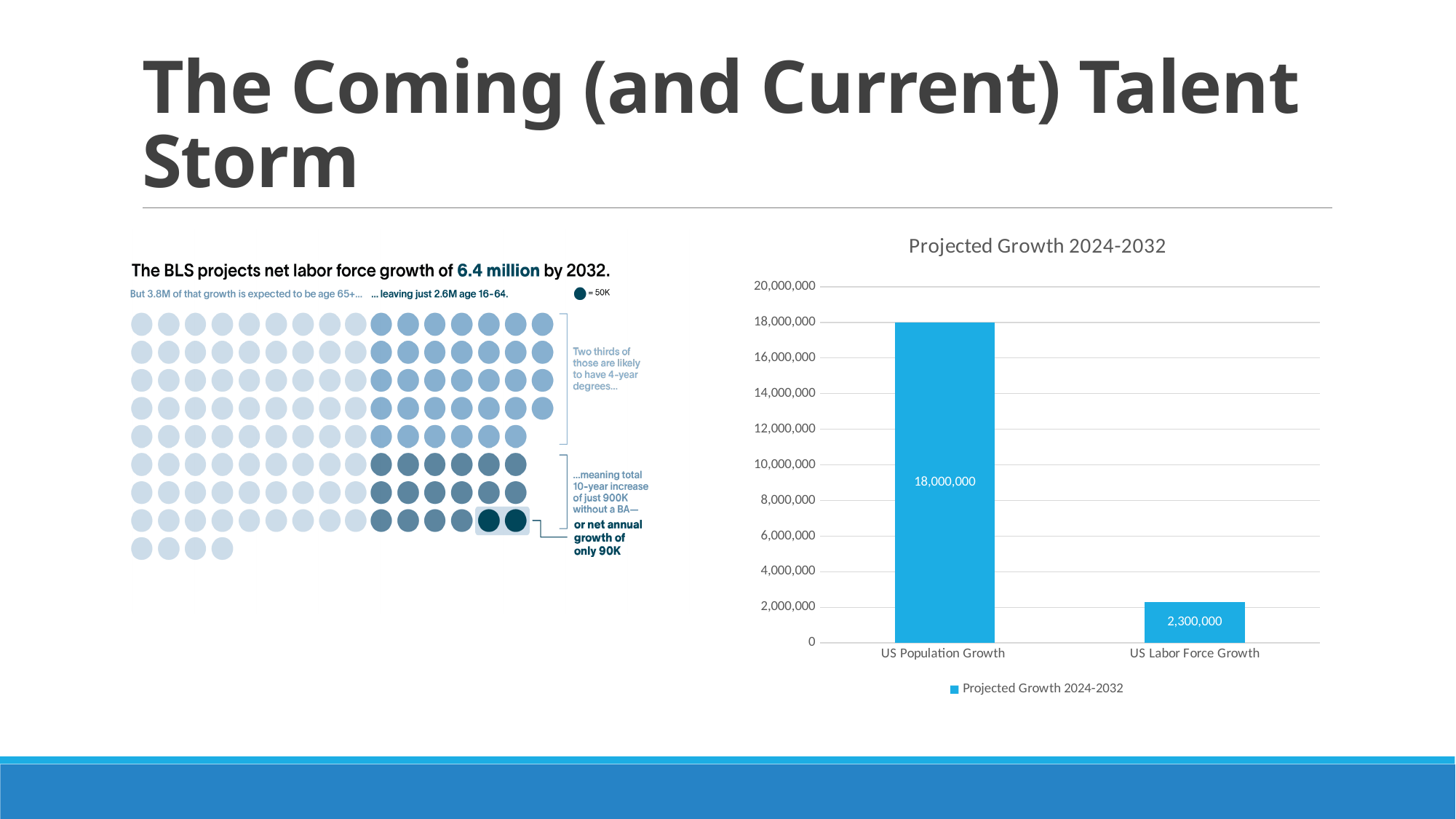
What kind of chart is the 'Projected Growth 2024-2032' chart on the right of the slide? Bar chart How many series does the legend of the 'Projected Growth 2024-2032' chart list? 1 In the 'Projected Growth 2024-2032' chart, is the value for US Population Growth greater or less than 16,000,000? greater How many categories are shown in the 'Projected Growth 2024-2032' chart? 2 In the 'Projected Growth 2024-2032' chart, is the value for US Labor Force Growth greater or less than 4,000,000? less In the 'Projected Growth 2024-2032' chart, what is the value for US Population Growth? 18,000,000 In the 'Projected Growth 2024-2032' chart, which category has the highest value? US Population Growth What is the title of the bar chart on the right side of the slide? Projected Growth 2024-2032 In the 'Projected Growth 2024-2032' chart, which is larger: US Population Growth or US Labor Force Growth? US Population Growth In the 'Projected Growth 2024-2032' chart, what is the value for US Labor Force Growth? 2,300,000 In the 'Projected Growth 2024-2032' chart, which category has the lowest value? US Labor Force Growth In the 'Projected Growth 2024-2032' chart, what is the difference between US Population Growth and US Labor Force Growth? 15,700,000